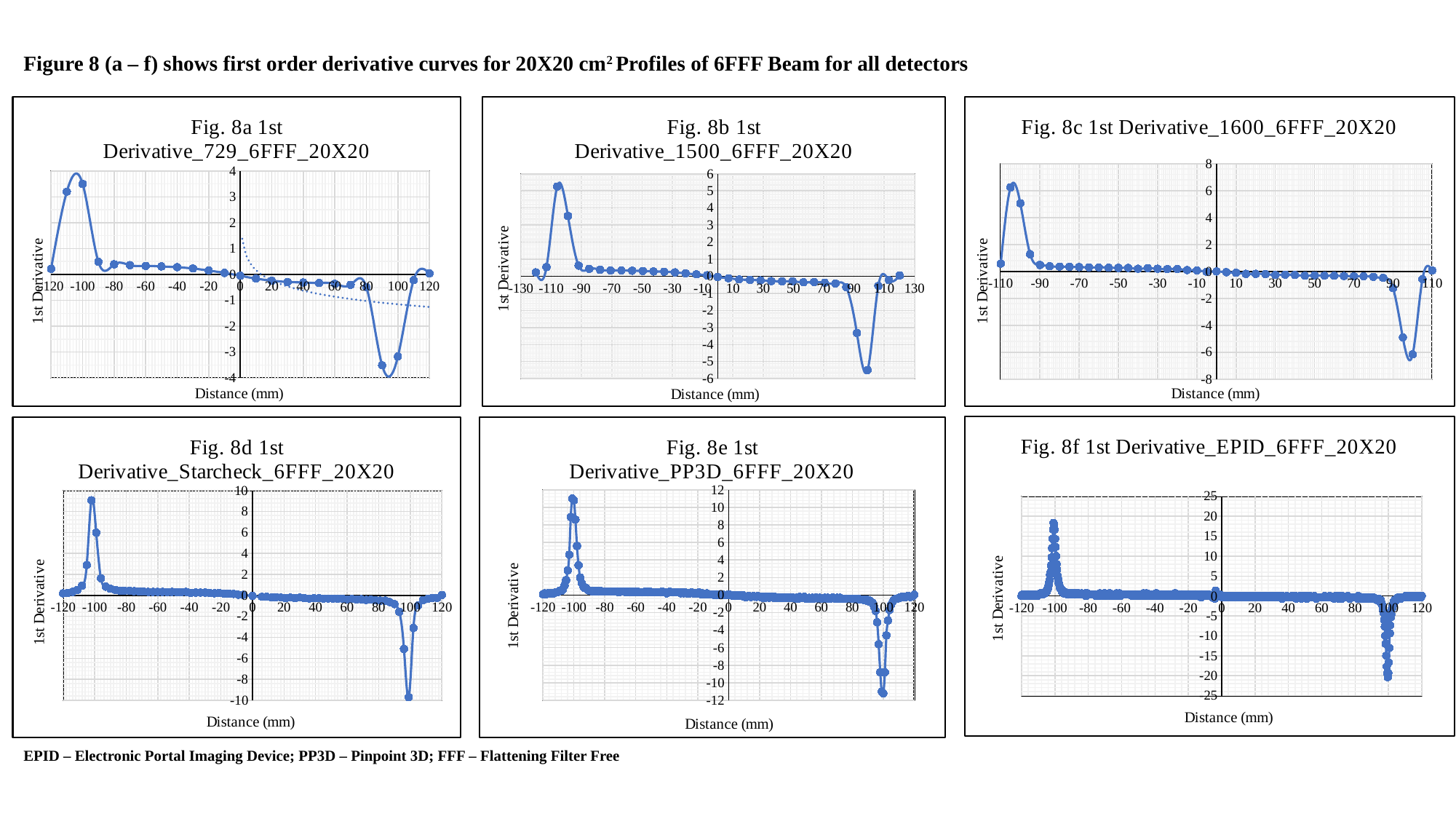
What kind of chart is Fig. 8a 1st Derivative_729_6FFF_20X20? line chart In Fig. 8f 1st Derivative_EPID_6FFF_20X20, is the lowest value near 100 mm greater or less than -15? less In Fig. 8a 1st Derivative_729_6FFF_20X20, is the lowest value near 90 mm greater or less than -3? less In Fig. 8c 1st Derivative_1600_6FFF_20X20, is the lowest value near 100 mm greater or less than -4? less What is the x-axis label of Fig. 8d 1st Derivative_Starcheck_6FFF_20X20? Distance (mm) How many charts are shown on the slide? 6 In Fig. 8a 1st Derivative_729_6FFF_20X20, between -80 mm and 80 mm, do the plotted values rise or fall as distance increases? fall